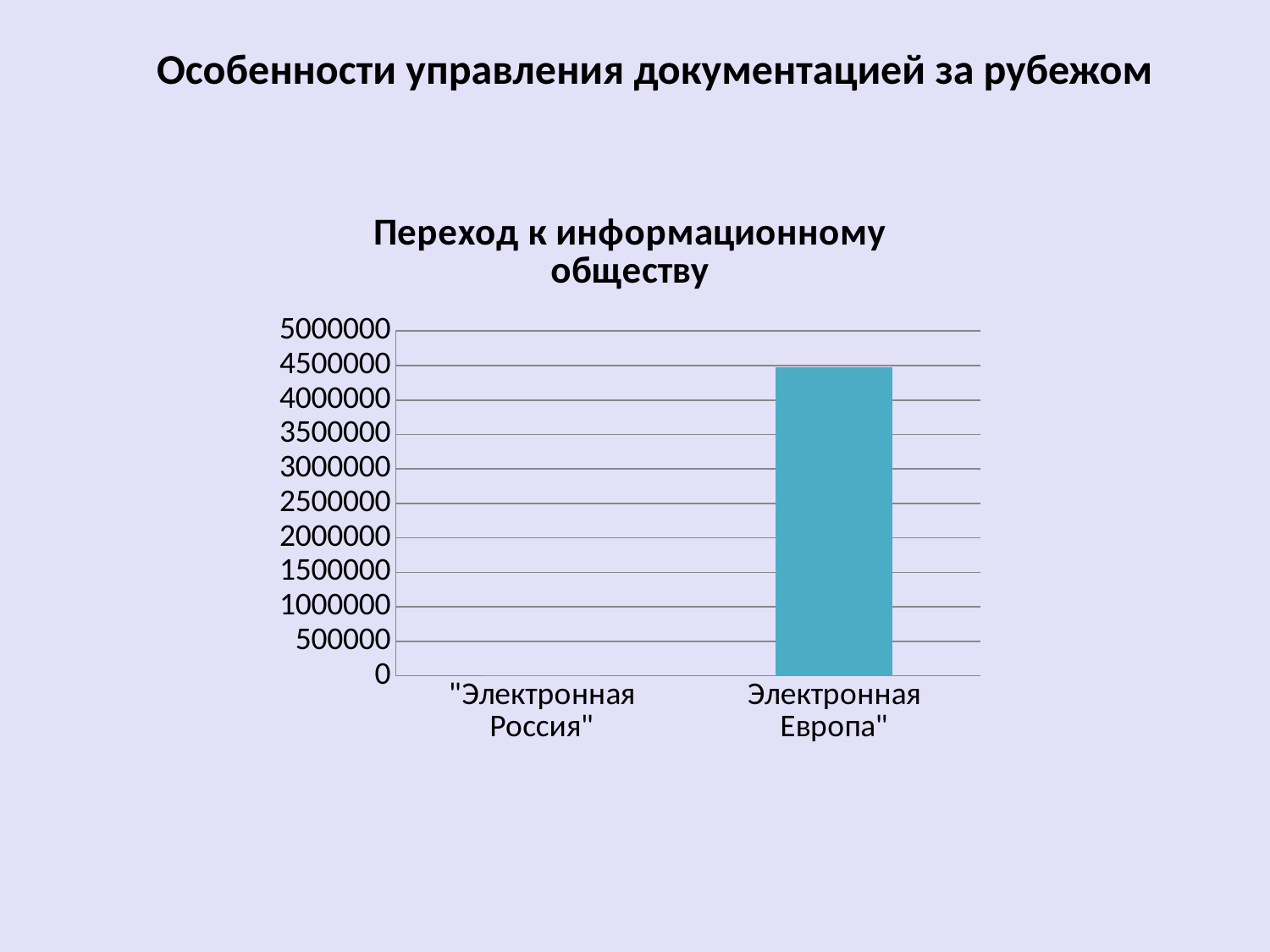
What is the title of the chart? Переход к информационному обществу Is the value for "Электронная Россия" greater or less than 500000? less Which category has the highest value in the chart? Электронная Европа How many categories are plotted in the chart? 2 What kind of chart is shown on the slide? bar chart Do the values rise or fall from left to right across the categories? rise What is the highest value shown on the vertical axis of the chart? 5000000 Is the value for "Электронная Европа" greater or less than 4000000? greater Which category has the lowest value in the chart? Электронная Россия Is the value for "Электронная Россия" greater or less than 1000000? less Which is larger, the value for "Электронная Россия" or the value for "Электронная Европа"? Электронная Европа